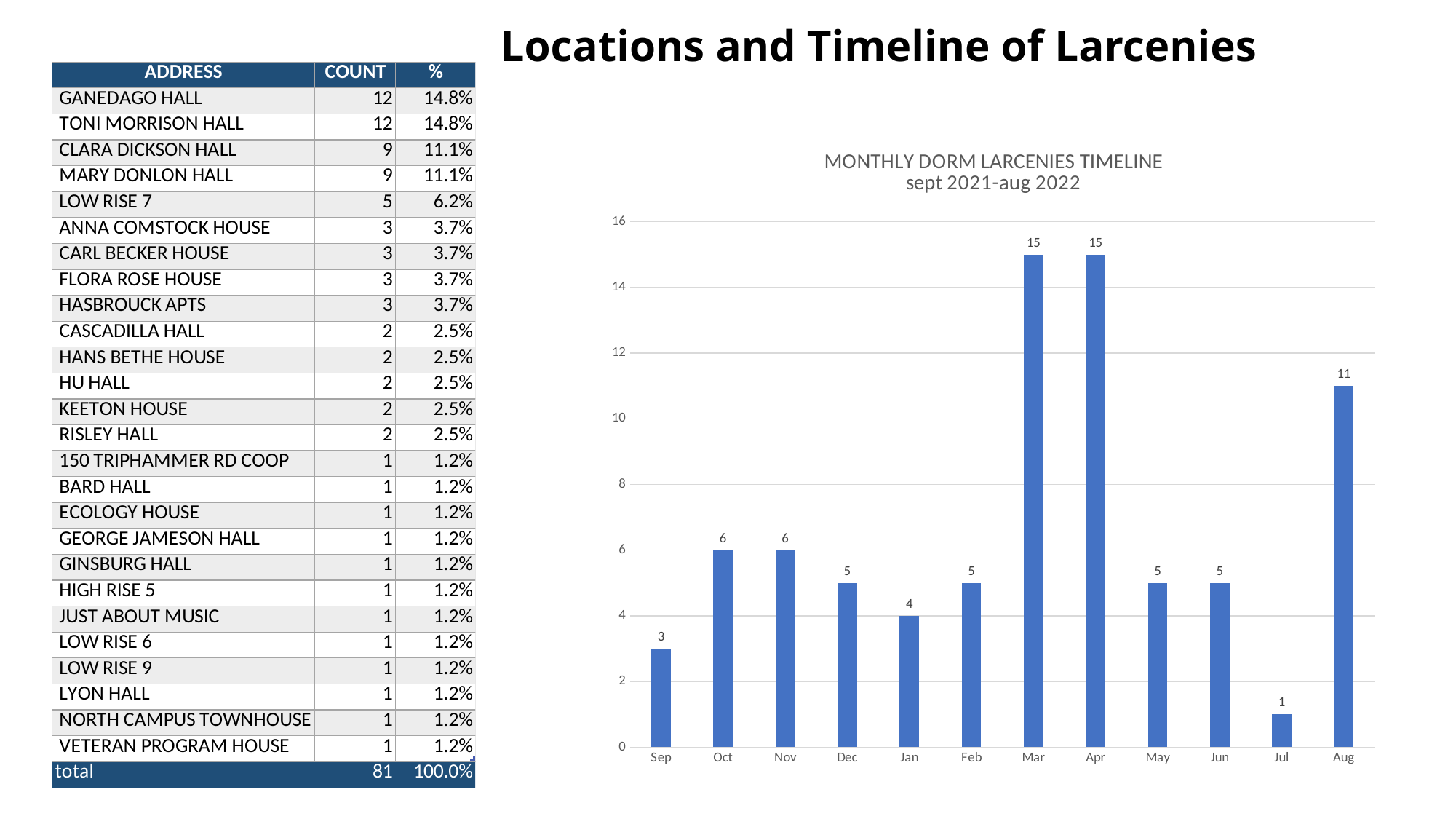
Is the value for Apr greater or less than 10 in the Monthly Dorm Larcenies Timeline chart? greater What is the difference between the values for Oct and Sep in the Monthly Dorm Larcenies Timeline chart? 3 Which two months share the highest value in the Monthly Dorm Larcenies Timeline chart? Mar and Apr What is the difference between the values for Mar and Aug in the Monthly Dorm Larcenies Timeline chart? 4 How many months are plotted in the Monthly Dorm Larcenies Timeline chart? 12 What period does the subtitle of the Monthly Dorm Larcenies Timeline chart cover? sept 2021-aug 2022 Which is larger in the Monthly Dorm Larcenies Timeline chart, the value for Nov or the value for Dec? Nov Which month has the lowest value in the Monthly Dorm Larcenies Timeline chart? Jul What kind of chart is the Monthly Dorm Larcenies Timeline? bar chart What is the value for Sep in the Monthly Dorm Larcenies Timeline chart? 3 What is the value for Aug in the Monthly Dorm Larcenies Timeline chart? 11 What is the value for Jan in the Monthly Dorm Larcenies Timeline chart? 4